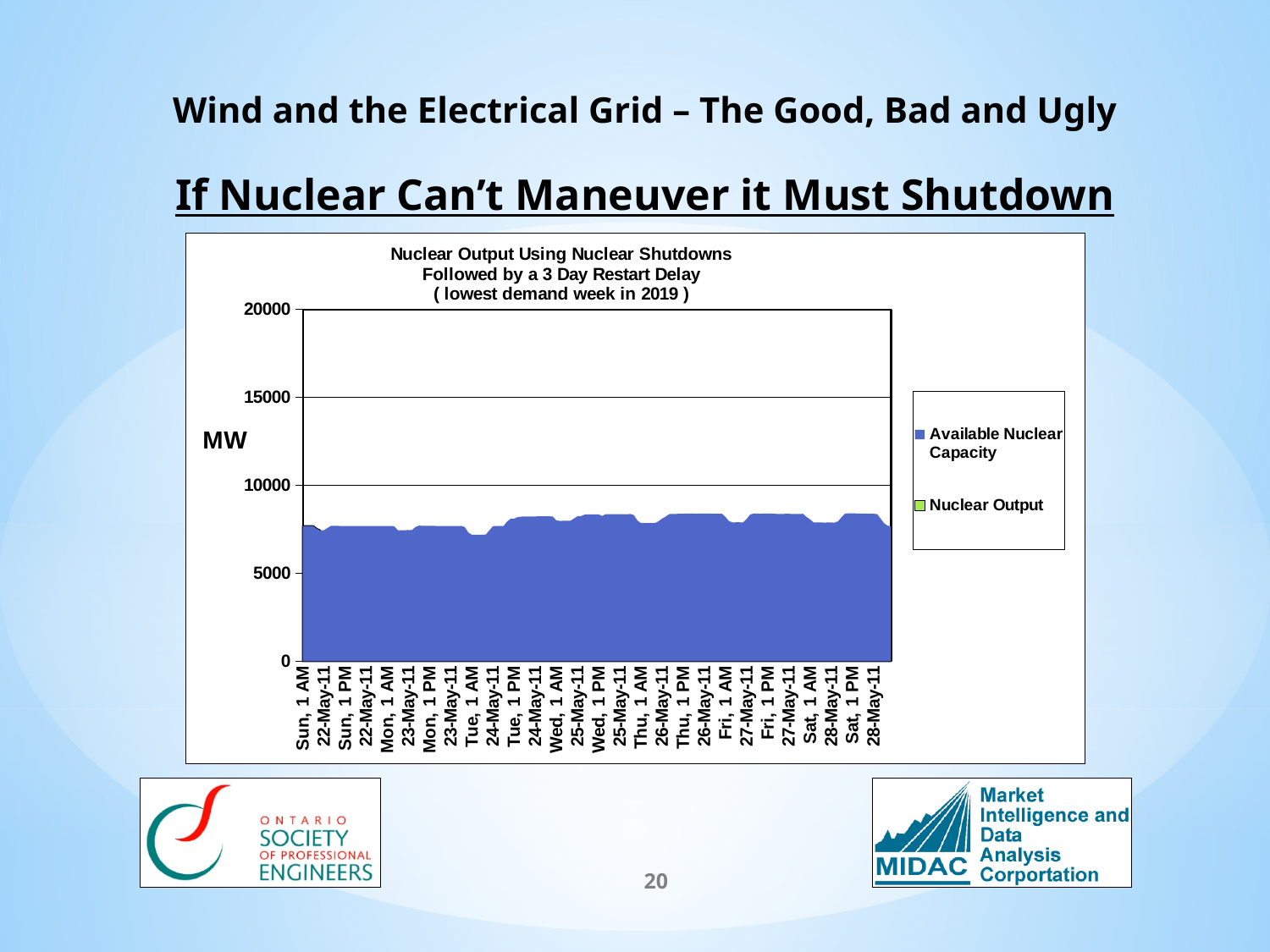
How many days of the week are labelled along the chart's x axis? 7 What unit is shown on the chart's vertical axis? MW Is the Available Nuclear Capacity at Wed, 1 PM 25-May-11 greater or less than 5000? greater Is the Available Nuclear Capacity at Sun, 1 AM 22-May-11 greater or less than 10000? less What are the two series named in the chart's legend? Available Nuclear Capacity; Nuclear Output How many series does the chart's legend list? 2 What kind of chart is shown on the slide? Area chart Does the Available Nuclear Capacity rise sharply, fall sharply, or stay roughly flat across the week shown on the x axis? Stays roughly flat Is the Available Nuclear Capacity at Sat, 1 PM 28-May-11 greater or less than 15000? less What is the title of the chart? Nuclear Output Using Nuclear Shutdowns Followed by a 3 Day Restart Delay ( lowest demand week in 2019 ) Which date is shown for the first x-axis label, Sun, 1 AM? 22-May-11 What is the highest value shown on the chart's vertical axis? 20000